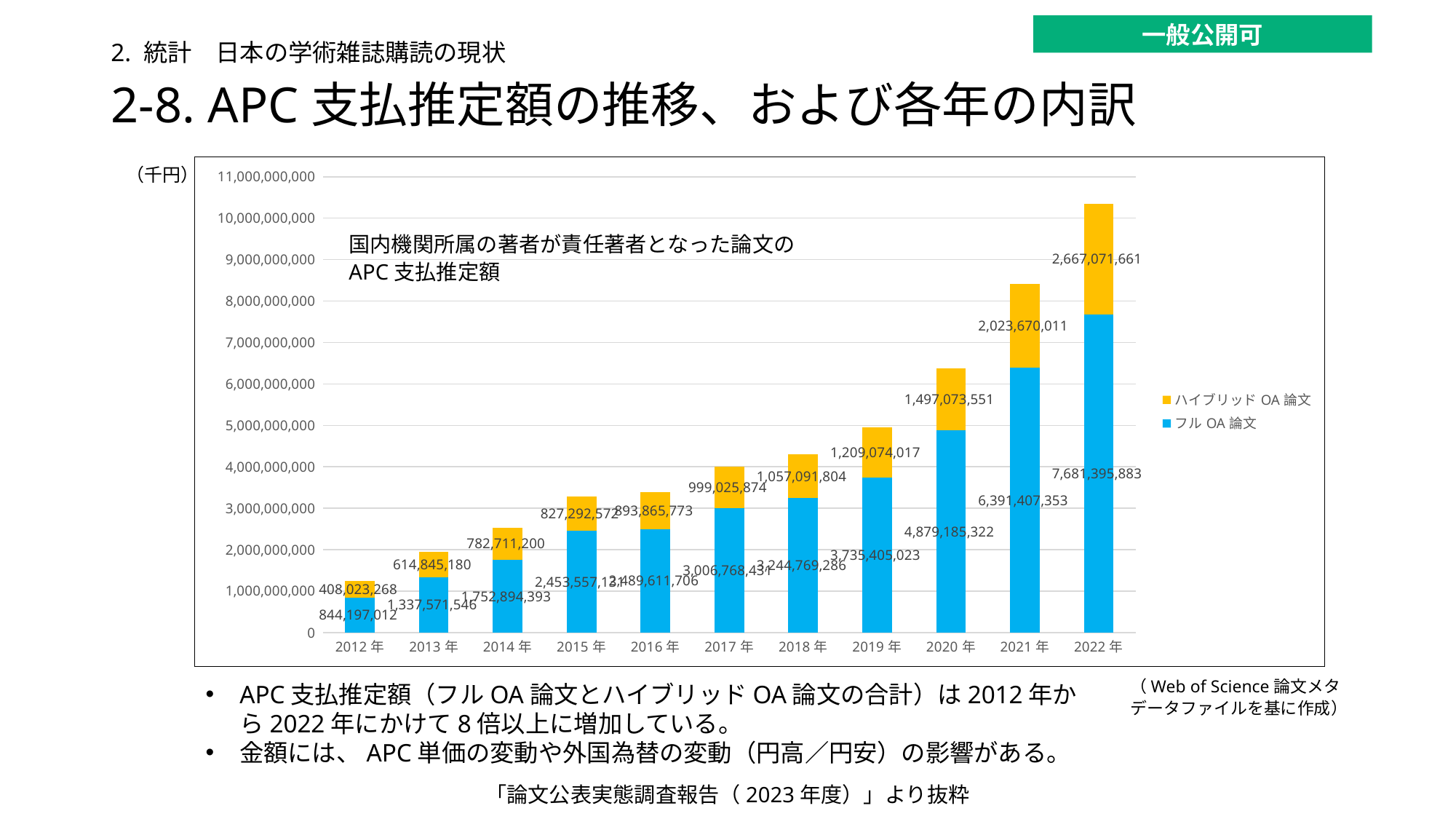
How many years are shown on the x axis? 11 What is the total of the stacked bar for 2022 年? 10,348,467,544 What is the value for ハイブリッド OA 論文 in 2021 年? 2,023,670,011 Which year has the highest total APC payment? 2022 年 What is the difference between the フル OA 論文 values for 2022 年 and 2021 年? 1,289,988,530 What is the value for ハイブリッド OA 論文 in 2012 年? 408,023,268 How many series does the legend list? 2 What is the value for フル OA 論文 in 2022 年? 7,681,395,883 Which year has the lowest value for フル OA 論文? 2012 年 What kind of chart is shown on the slide? Stacked bar chart What is the value for フル OA 論文 in 2019 年? 3,735,405,023 Do the total values rise or fall from 2012 年 to 2022 年? Rise